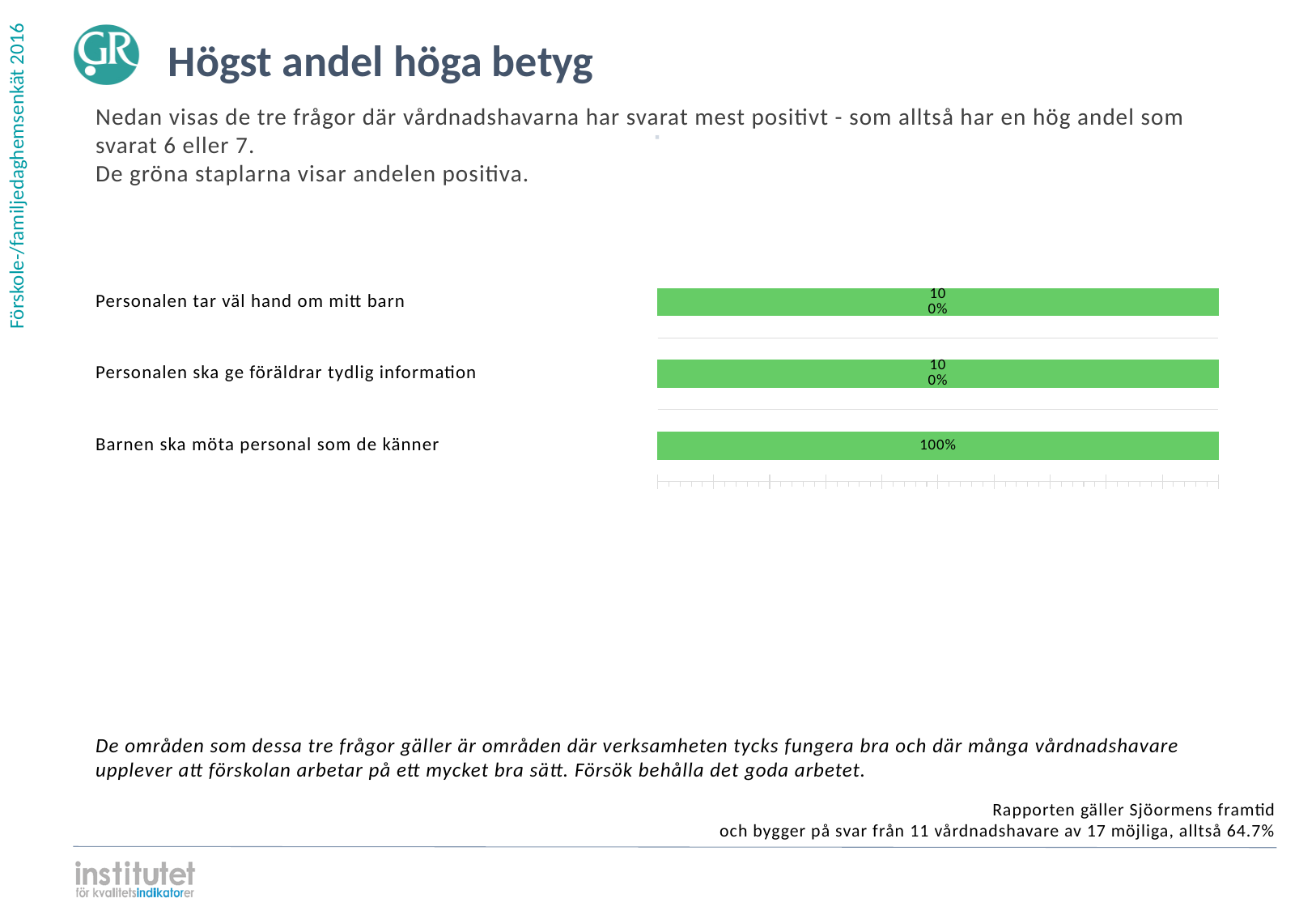
How many categories are shown in the chart? 3 What colour are the bars in the chart? Green Do all three categories in the chart have the same value? Yes What is the value for "Personalen tar väl hand om mitt barn"? 100% What kind of chart is shown on the slide? Bar chart What is the value for "Personalen ska ge föräldrar tydlig information"? 100% What is the value for "Barnen ska möta personal som de känner"? 100% What is the difference between the values for "Personalen tar väl hand om mitt barn" and "Barnen ska möta personal som de känner"? 0% What is the title of the slide containing the chart? Högst andel höga betyg